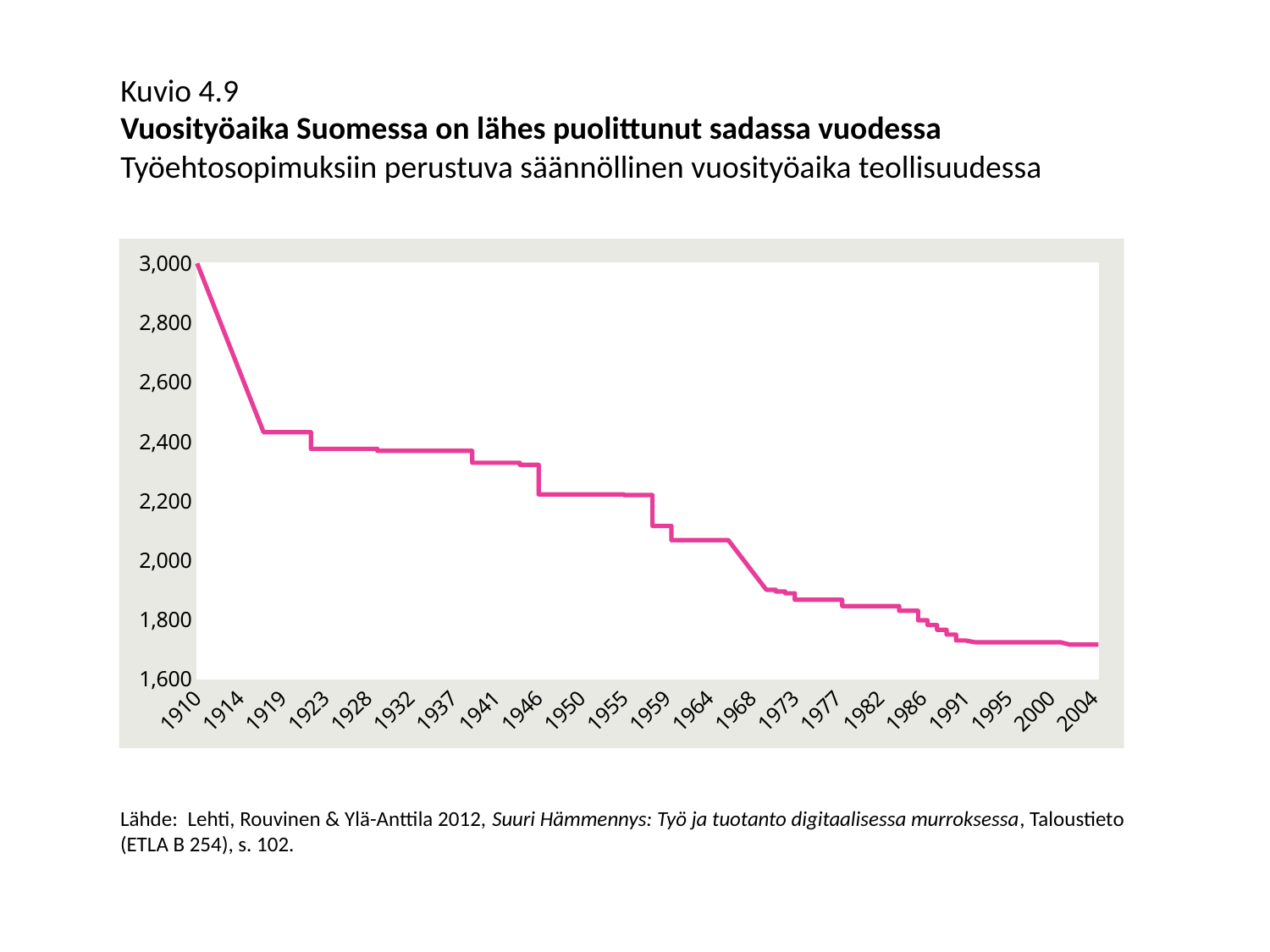
Is the value for 1964 greater or less than 2,000? greater Is the value for 2004 greater or less than 1,800? less Is the value for 1973 greater or less than 2,000? less What kind of chart is shown on the slide? line chart Which year has the highest value on the chart? 1910 What is the bold title of the chart? Vuosityöaika Suomessa on lähes puolittunut sadassa vuodessa Do the values rise or fall along the x axis from 1910 to 2004? fall Which is larger, the value for 1941 or the value for 1968? 1941